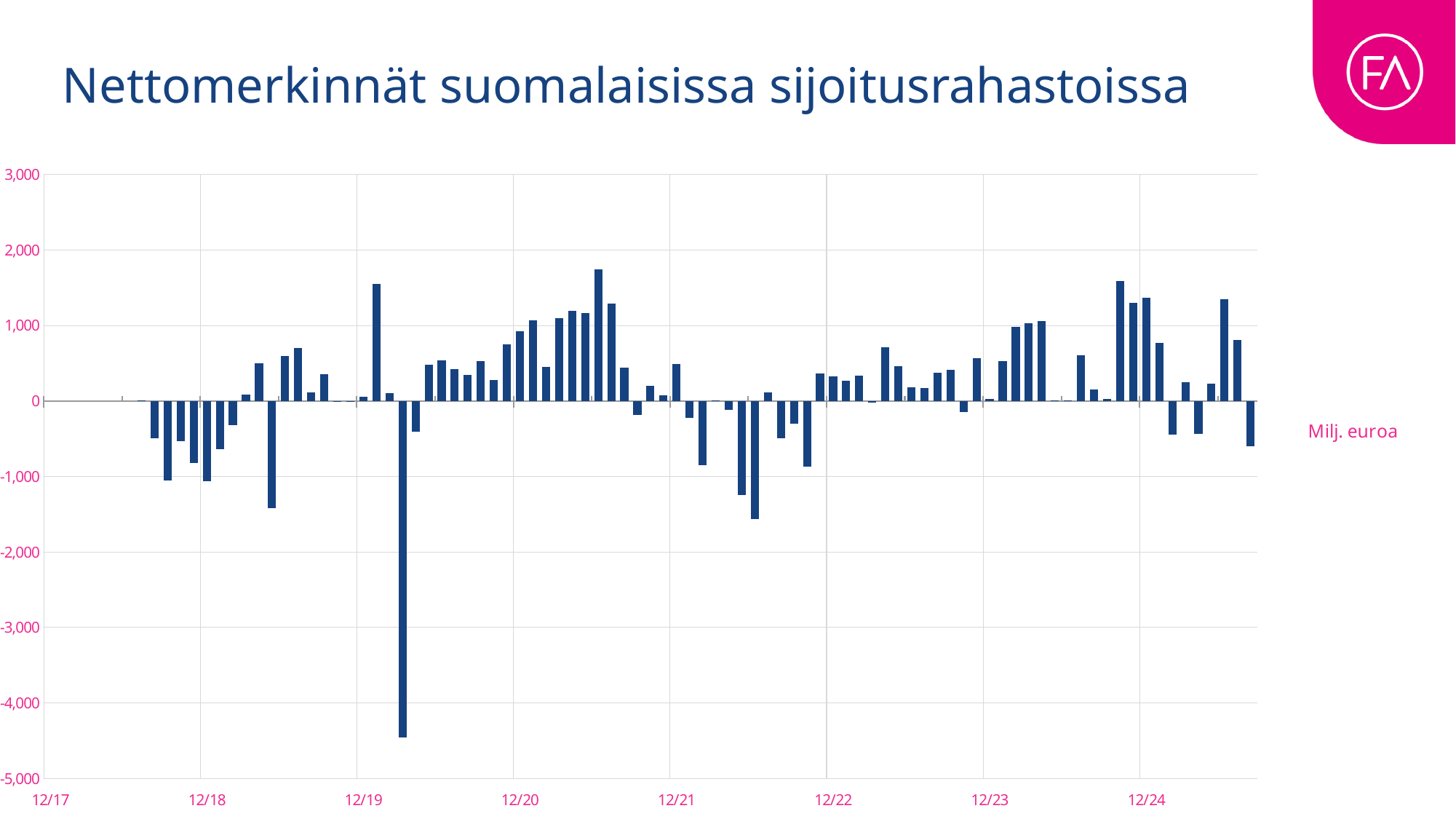
How many labels are shown on the x axis? 8 Is the last bar on the right of the chart greater or less than 0? less Is the highest value on the chart greater or less than 2,000? less What is the title of the chart? Nettomerkinnät suomalaisissa sijoitusrahastoissa What is the highest tick value shown on the y axis? 3,000 Is the highest value on the chart greater or less than 1,000? greater Between which two x-axis labels does the highest bar on the chart occur? 12/20 and 12/21 Between which two x-axis labels does the lowest bar on the chart occur? 12/19 and 12/20 What kind of chart is shown on the slide? Bar chart What unit is indicated next to the chart? Milj. euroa